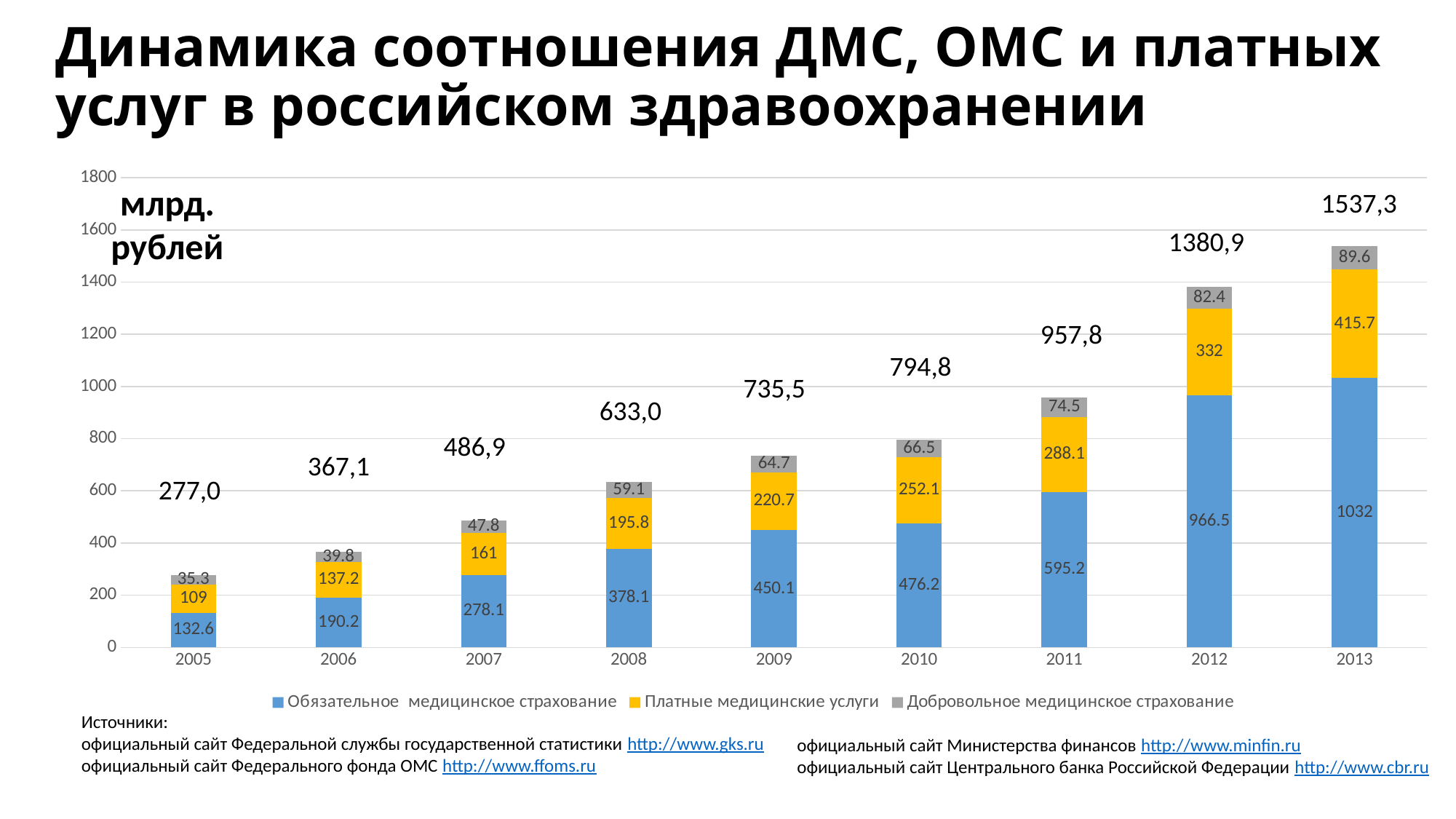
What is the difference between the Платные медицинские услуги values for 2013 and 2012? 83.7 Which is larger: Добровольное медицинское страхование in 2010 or in 2008? 2010 Which year has the highest total? 2013 Which year has the lowest value for Обязательное медицинское страхование? 2005 How many series does the legend list? 3 What is the total of the stacked bar for 2012? 1380,9 What is the value for Добровольное медицинское страхование in 2013? 89.6 What is the value for Обязательное медицинское страхование in 2011? 595.2 Do the totals rise or fall from 2005 to 2013? Rise How many years are shown on the x axis? 9 What type of chart is shown on the slide? Stacked bar chart What is the value for Платные медицинские услуги in 2009? 220.7